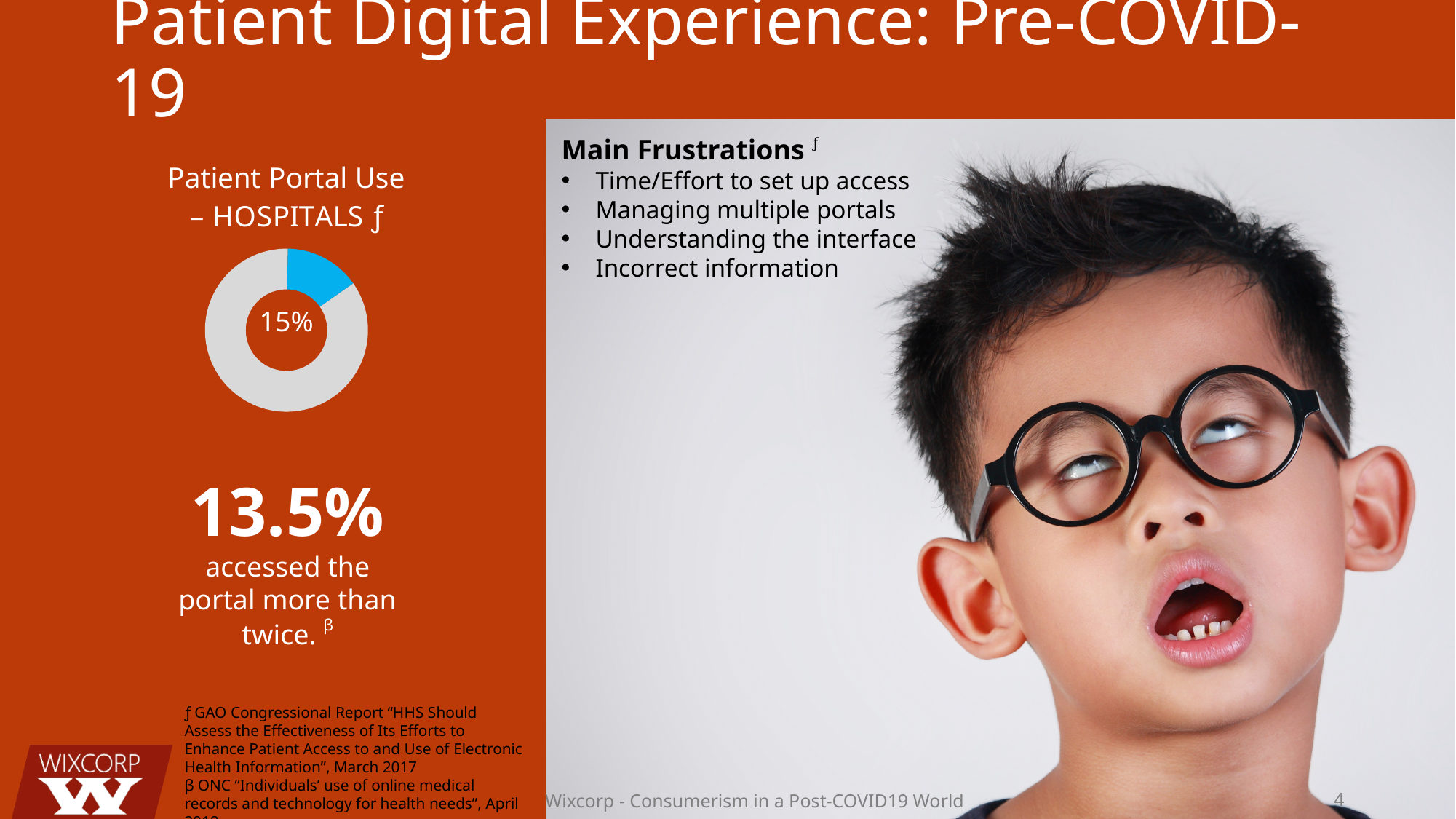
What is the title of the donut chart on the slide? Patient Portal Use – HOSPITALS What percentage is printed in the centre of the "Patient Portal Use – HOSPITALS" donut chart? 15% How many slices does the "Patient Portal Use – HOSPITALS" donut chart have? 2 Is the value shown in the "Patient Portal Use – HOSPITALS" donut chart greater or less than 50%? less In the "Patient Portal Use – HOSPITALS" donut chart, is the blue slice larger or smaller than the grey portion? Smaller In the "Patient Portal Use – HOSPITALS" donut chart, what share does the blue slice represent? 15% What kind of chart is shown under the title "Patient Portal Use – HOSPITALS"? Donut (pie) chart What colour is the highlighted 15% slice in the "Patient Portal Use – HOSPITALS" donut chart? Blue